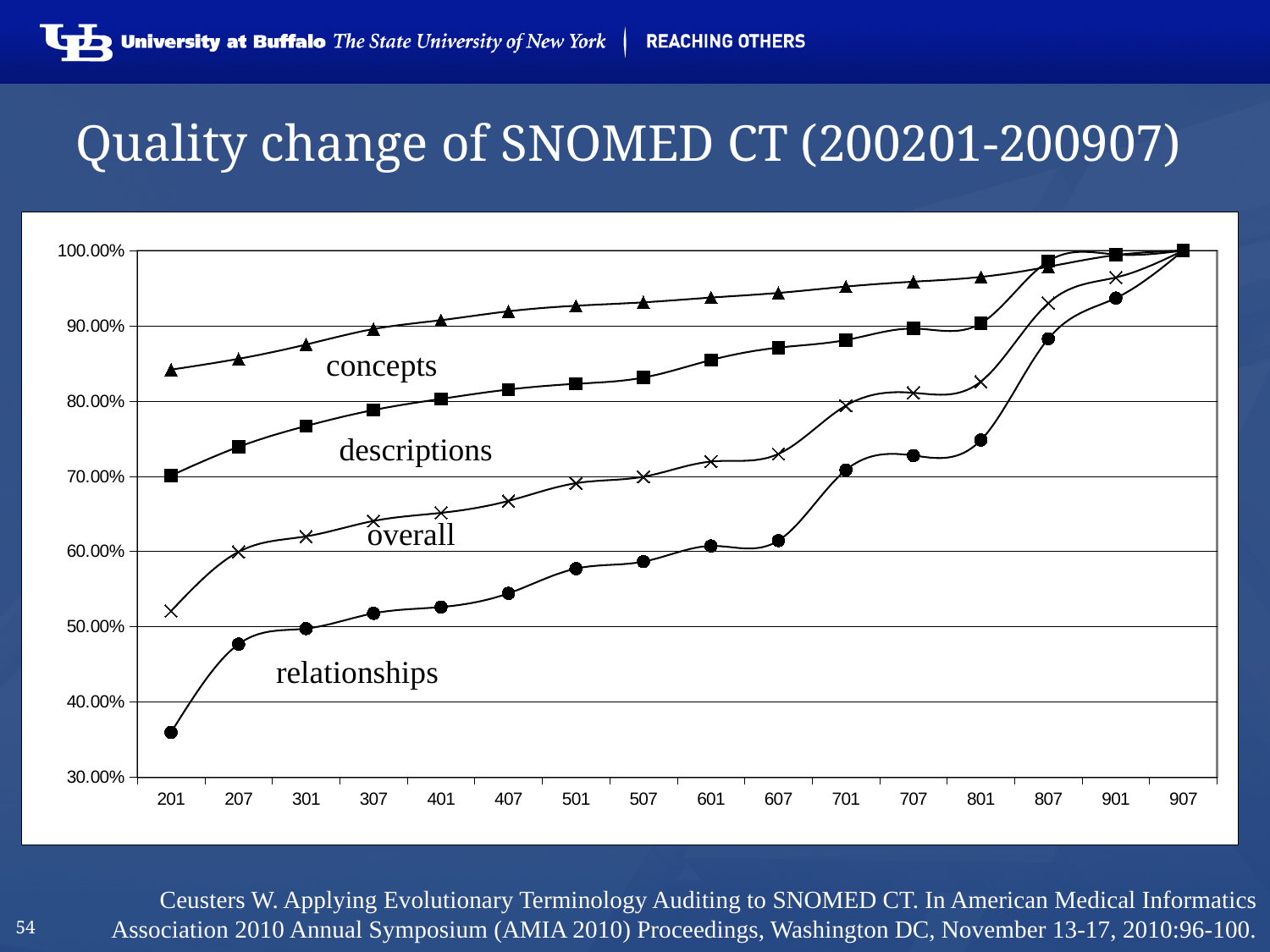
What value does the concepts series reach at 907? 100.00% At 401, which is larger: concepts or descriptions? concepts What kind of chart is shown on the slide? line chart Is the value for relationships at 801 greater or less than 80.00%? less Is the value for relationships at 201 greater or less than 40.00%? less How many points are on the x axis of the chart? 16 Is the value for concepts at 201 greater or less than 80.00%? greater Do the values of the relationships series rise or fall from 201 to 907? rise Which series has the lowest value at 201? relationships Which series has the highest value at 201? concepts How many series are plotted on the chart? 4